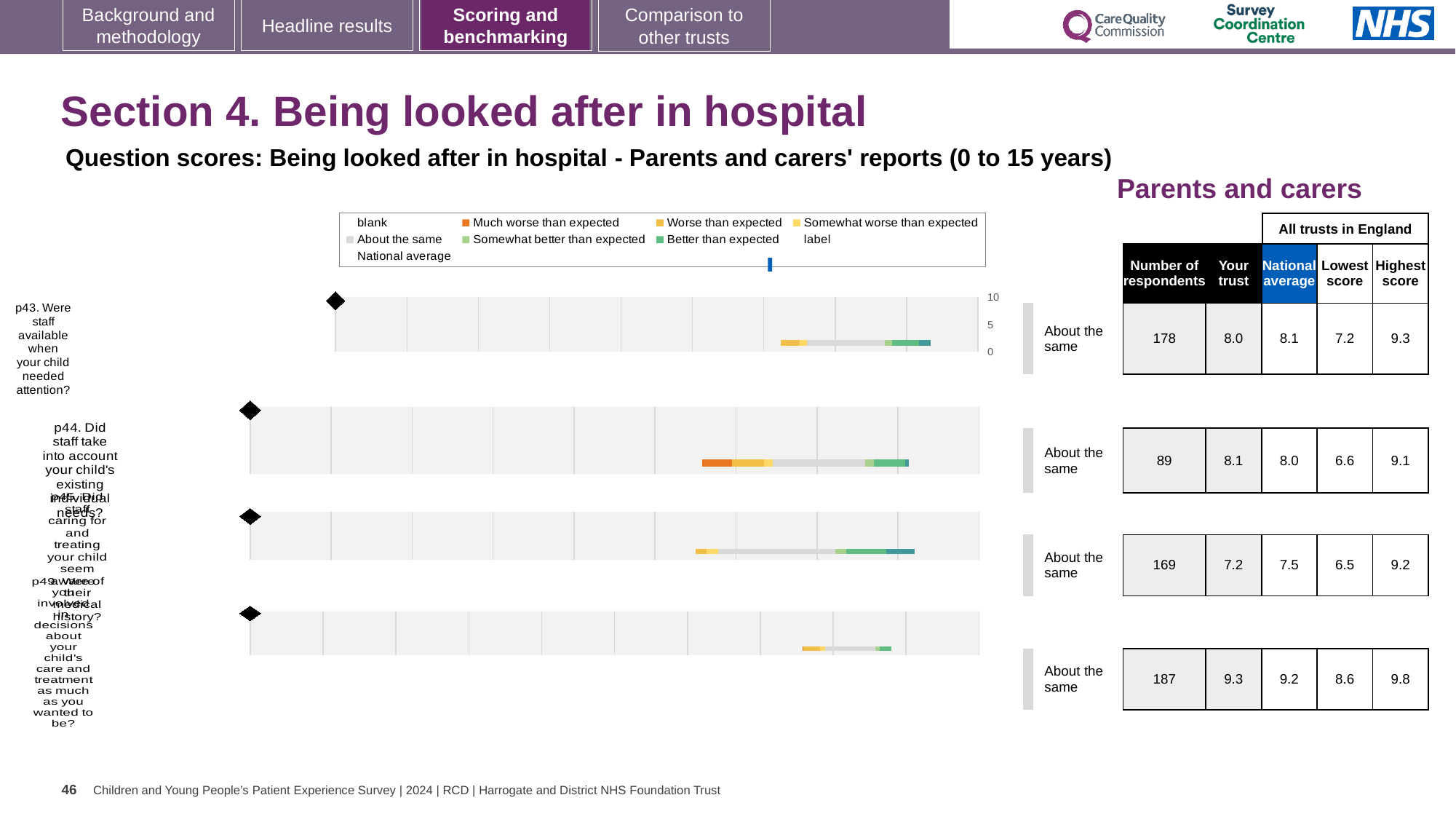
Which question has the lowest 'Your trust' score? p45 For p45 (Did staff caring for and treating your child seem aware of their medical history?), what is the national average score? 7.5 For p44 (Did staff take into account your child's existing individual needs?), what is the 'Your trust' score? 8.1 For p43 (Were staff available when your child needed attention?), what is the number of respondents shown in the table? 178 What is the maximum value shown on the score axis of the chart? 10 For p45, what is the difference between the highest score and the lowest score among all trusts in England? 2.7 What kind of chart is used to show the question scores on this slide? bar chart Which question has the highest 'Your trust' score? p49 For p43, which is larger: the 'Your trust' score or the national average? National average How many questions (bars) are plotted on the slide? 4 What is the benchmark category shown next to each bar for all four questions? About the same For p49 (Were you involved in decisions about your child's care and treatment as much as you wanted to be?), what is the highest score among all trusts in England? 9.8